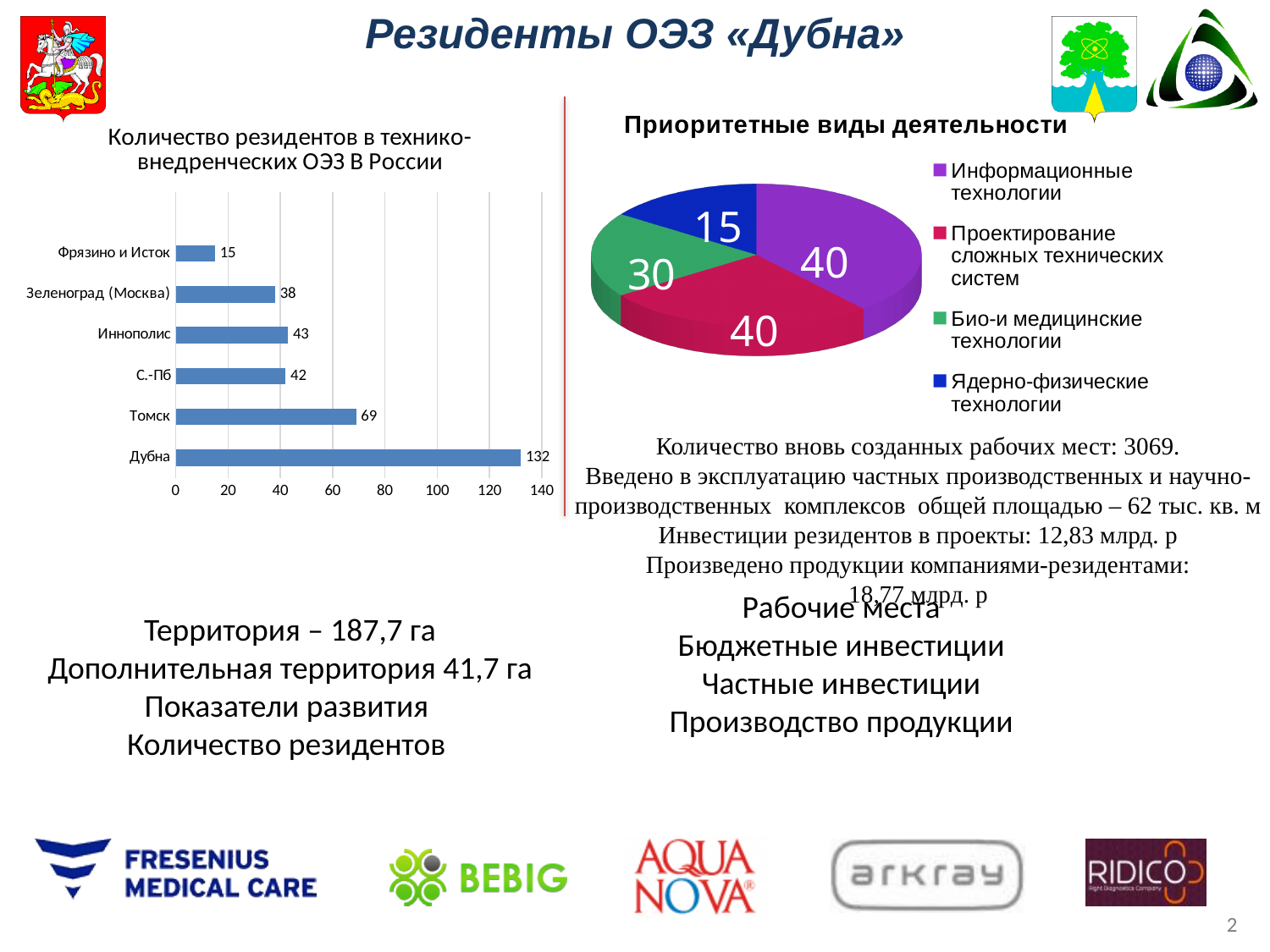
In the pie chart 'Приоритетные виды деятельности', what is the value for Ядерно-физические технологии? 15 In the pie chart 'Приоритетные виды деятельности', which colour represents Информационные технологии? Purple In the pie chart 'Приоритетные виды деятельности', how many entries does the legend list? 4 What kind of chart is 'Количество резидентов в технико-внедренческих ОЭЗ В России'? Bar chart In the bar chart 'Количество резидентов в технико-внедренческих ОЭЗ В России', which category has the lowest value? Фрязино и Исток In the bar chart 'Количество резидентов в технико-внедренческих ОЭЗ В России', what is the value for Дубна? 132 In the bar chart 'Количество резидентов в технико-внедренческих ОЭЗ В России', how many categories are shown? 6 In the bar chart 'Количество резидентов в технико-внедренческих ОЭЗ В России', which category has the highest value? Дубна In the bar chart 'Количество резидентов в технико-внедренческих ОЭЗ В России', what is the difference between the values for Дубна and Томск? 63 In the bar chart 'Количество резидентов в технико-внедренческих ОЭЗ В России', which is larger: Зеленоград (Москва) or Томск? Томск In the pie chart 'Приоритетные виды деятельности', what is the value for Био-и медицинские технологии? 30 In the bar chart 'Количество резидентов в технико-внедренческих ОЭЗ В России', what is the value for Томск? 69